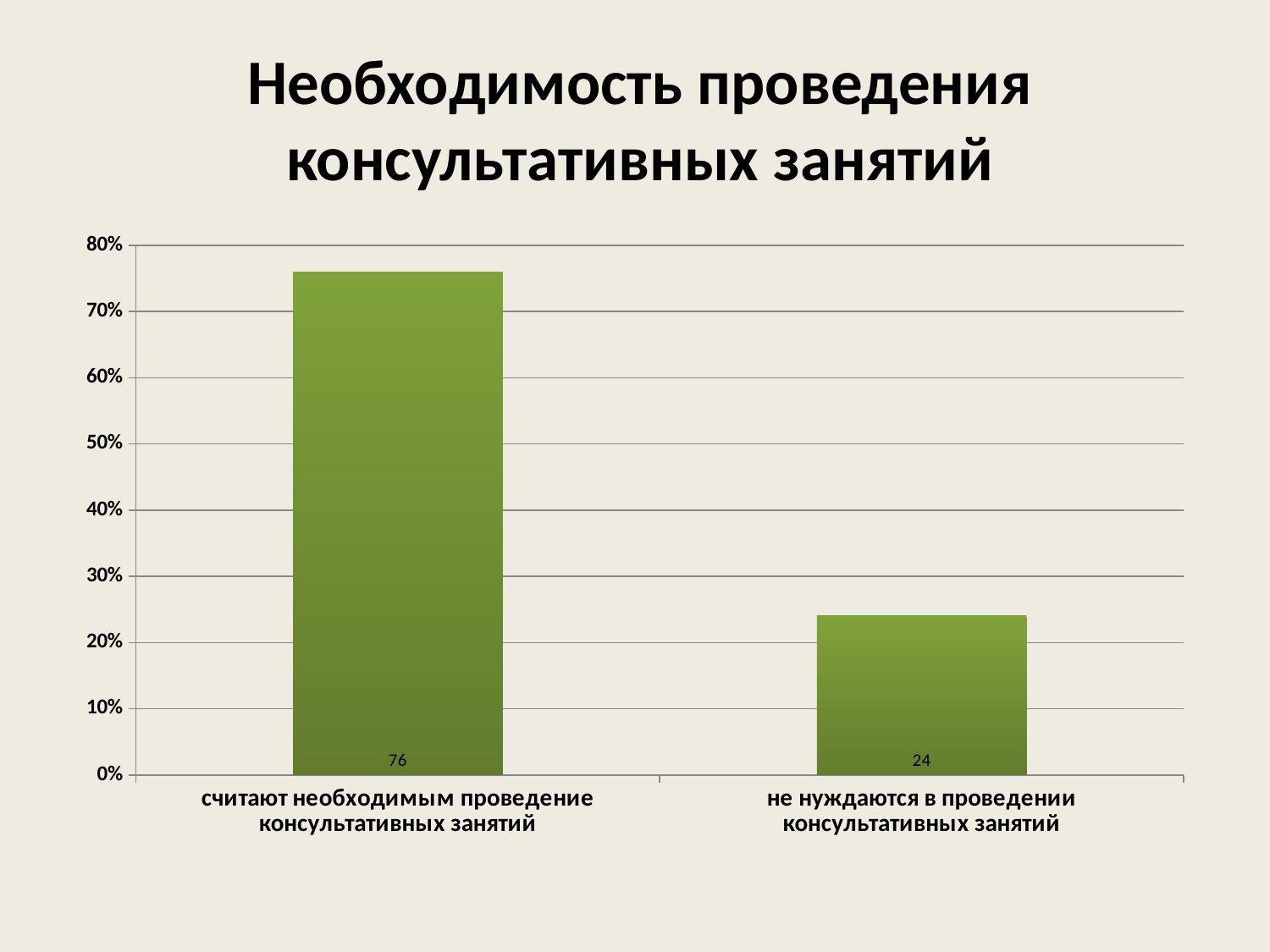
What is the highest value shown on the vertical axis? 80% How many categories are shown on the chart? 2 What is the difference between the values for "считают необходимым проведение консультативных занятий" and "не нуждаются в проведении консультативных занятий"? 52 What is the value for "не нуждаются в проведении консультативных занятий"? 24 Is the value for "не нуждаются в проведении консультативных занятий" greater or less than 30%? less What is the value for "считают необходимым проведение консультативных занятий"? 76 What kind of chart is shown on the slide? bar chart Which category has the lowest value? не нуждаются в проведении консультативных занятий Which is larger: the value for "считают необходимым проведение консультативных занятий" or for "не нуждаются в проведении консультативных занятий"? считают необходимым проведение консультативных занятий Is the value for "считают необходимым проведение консультативных занятий" greater or less than 70%? greater Which category has the highest value? считают необходимым проведение консультативных занятий What is the title of the slide? Необходимость проведения консультативных занятий